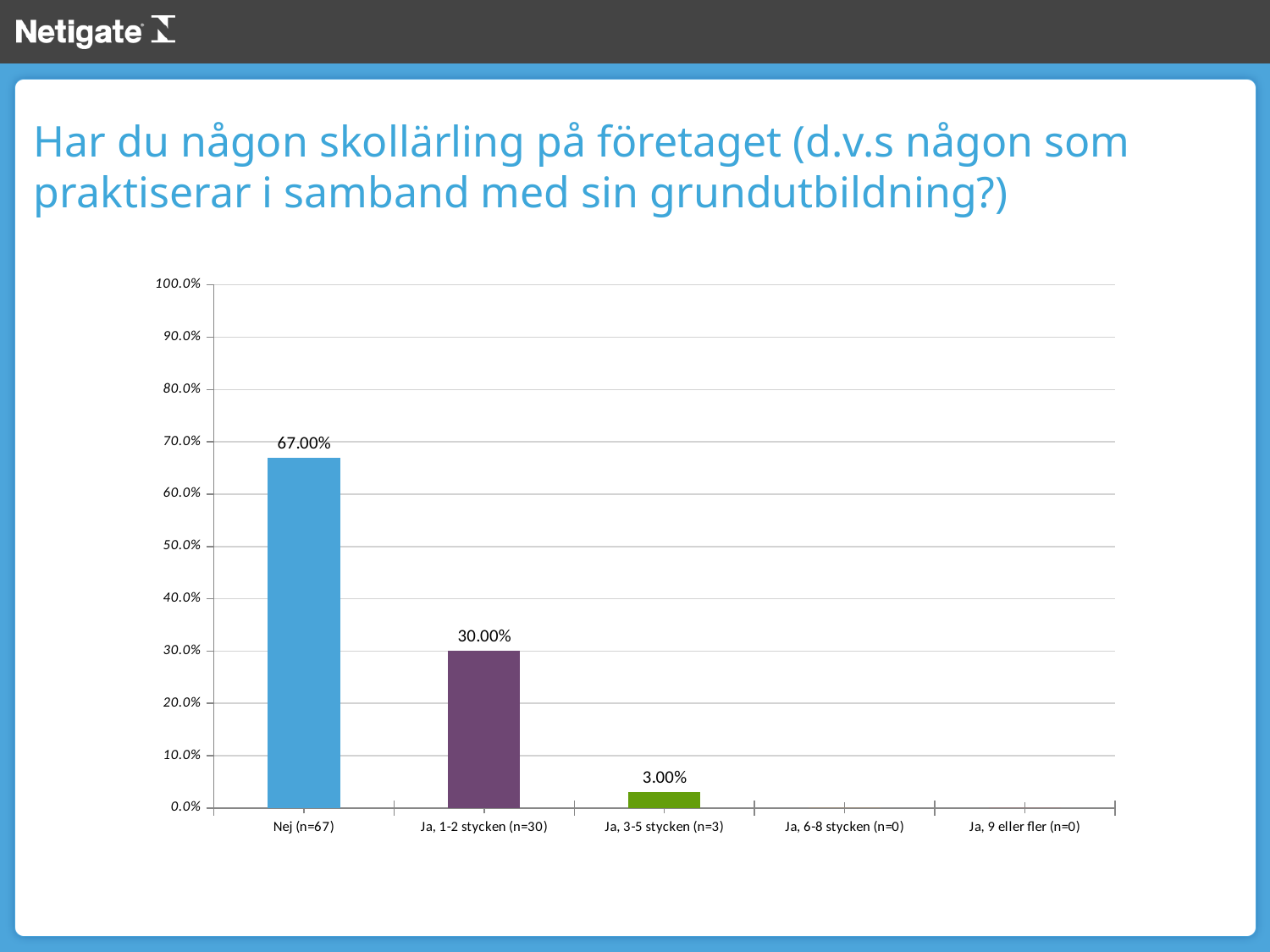
Is the value for "Ja, 3-5 stycken (n=3)" greater or less than 10.0%? less What is the difference between the values for "Nej (n=67)" and "Ja, 1-2 stycken (n=30)"? 37.00% Which is larger, the value for "Ja, 1-2 stycken (n=30)" or "Ja, 3-5 stycken (n=3)"? Ja, 1-2 stycken (n=30) How many categories are shown on the x axis? 5 Do the values rise or fall from left to right along the x axis? fall What is the value for "Ja, 1-2 stycken (n=30)"? 30.00% Is the value for "Nej (n=67)" greater or less than 60.0%? greater What kind of chart is shown on the slide? bar chart What is the value for "Ja, 3-5 stycken (n=3)"? 3.00% Which category has the highest value? Nej (n=67) What is the difference between the values for "Ja, 1-2 stycken (n=30)" and "Ja, 3-5 stycken (n=3)"? 27.00% What is the value for "Nej (n=67)"? 67.00%